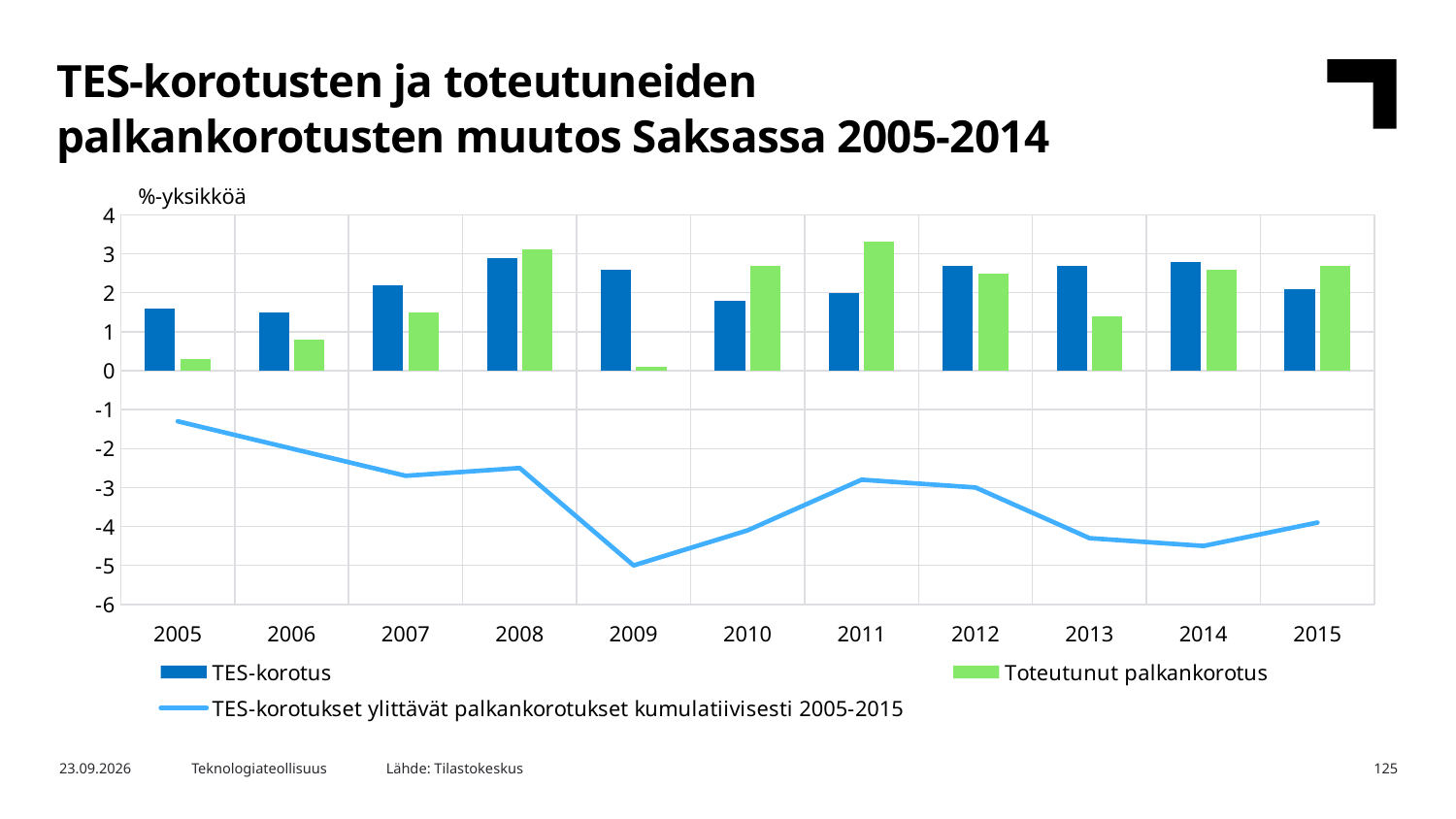
Is the TES-korotus value for 2008 greater or less than 2? greater In which year is the line 'TES-korotukset ylittävät palkankorotukset kumulatiivisesti 2005-2015' at its highest point? 2005 In which year does the line 'TES-korotukset ylittävät palkankorotukset kumulatiivisesti 2005-2015' reach its lowest point? 2009 How many series does the legend list? 3 Is the value of the cumulative line for 2009 greater or less than -4? less Does the cumulative line rise or fall from 2005 to 2009? It falls In which year is the Toteutunut palkankorotus bar the lowest? 2009 Is the Toteutunut palkankorotus value for 2009 greater or less than 1? less What kind of chart is shown on the slide? A combined bar and line chart How many years are shown on the x axis? 11 In 2011, which is larger: TES-korotus or Toteutunut palkankorotus? Toteutunut palkankorotus In 2005, which is larger: TES-korotus or Toteutunut palkankorotus? TES-korotus